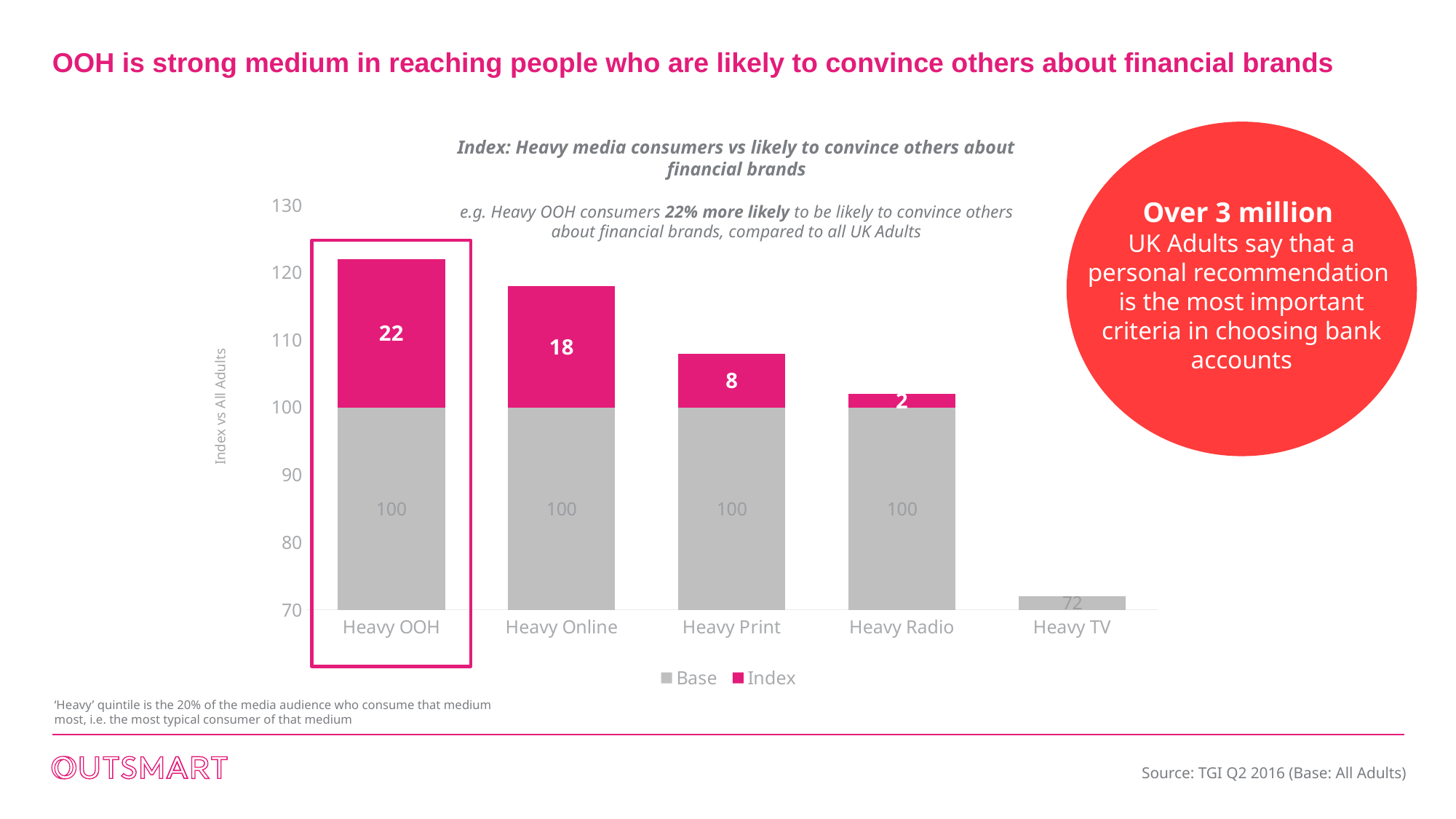
What is the difference between the Index values for Heavy OOH and Heavy Print? 14 Which has a larger Index value, Heavy Online or Heavy Radio? Heavy Online What is the label of the y axis? Index vs All Adults What is the Index value for Heavy Online? 18 Which category has the lowest Base value? Heavy TV What is the total height of the stacked bar for Heavy Online (Base plus Index)? 118 What is the Base value for Heavy TV? 72 What is the Index value for Heavy OOH? 22 Which category has the highest Index value? Heavy OOH What kind of chart is shown on the slide? Stacked bar chart How many categories are shown on the x axis? 5 How many series does the legend list? 2